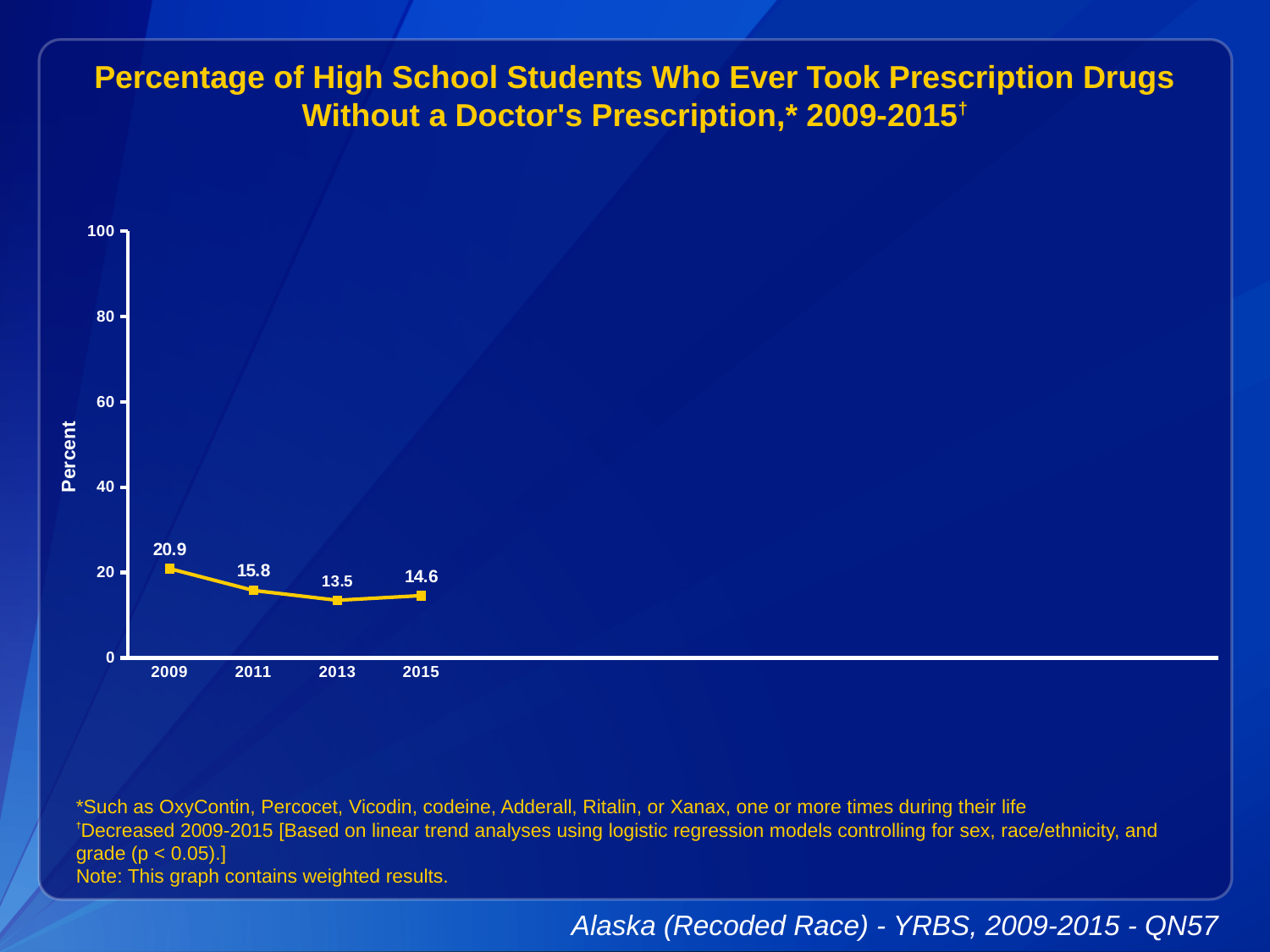
How many years are plotted on the chart? 4 Is the value for 2009 greater or less than 40? less What is the difference between the values for 2015 and 2013? 1.1 What is the value for 2015? 14.6 Which year has the lowest value? 2013 What kind of chart is shown? line chart Which is larger, the value for 2011 or the value for 2015? 2011 What is the difference between the values for 2009 and 2011? 5.1 What is the label of the y axis? Percent What is the value for 2009? 20.9 Which year has the highest value? 2009 What is the value for 2013? 13.5